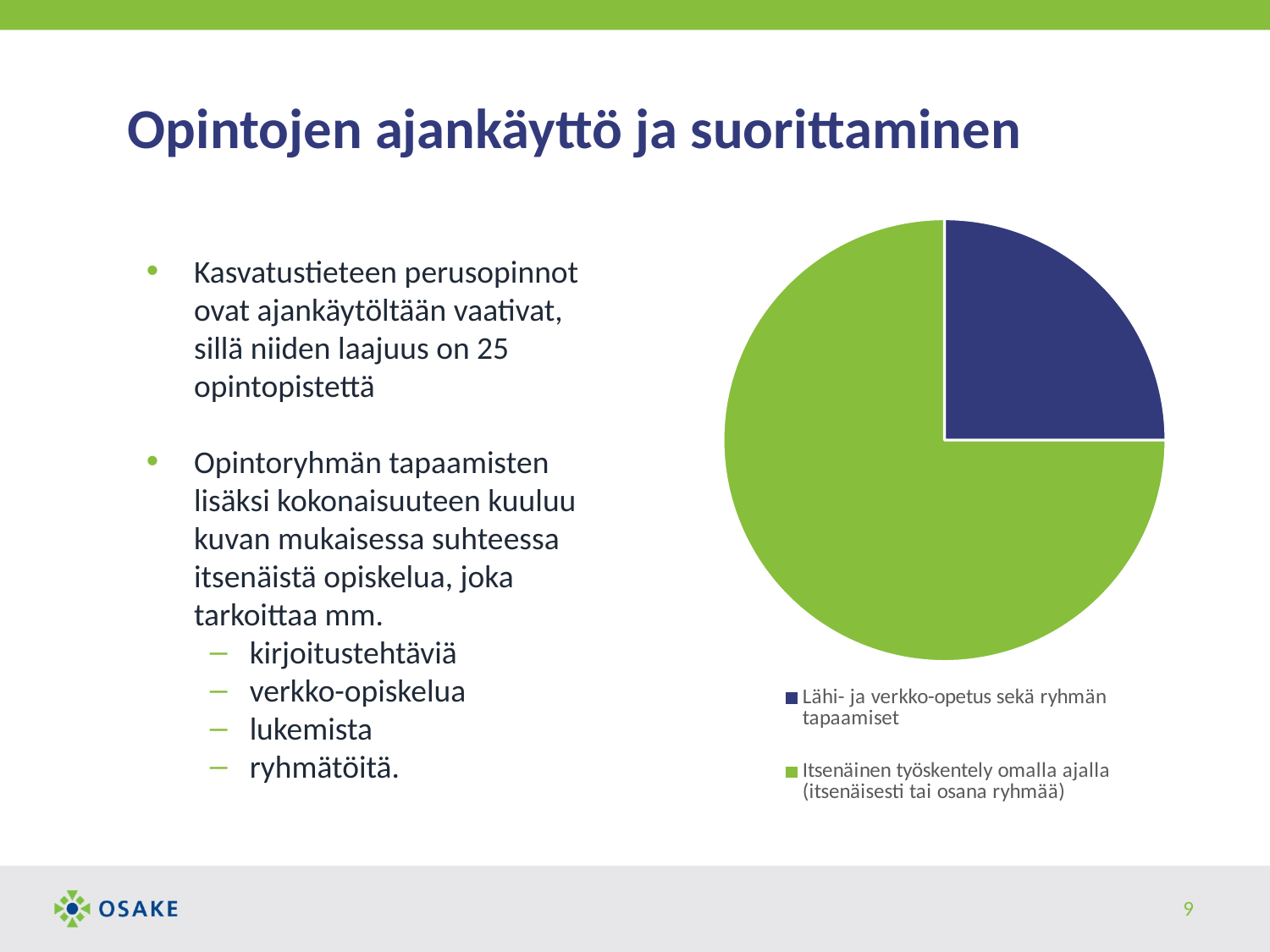
How many slices does the pie chart have? 2 How many entries does the legend of the pie chart list? 2 Which slice of the pie chart is the smallest? Lähi- ja verkko-opetus sekä ryhmän tapaamiset What kind of chart is shown on the slide? pie chart Which is larger in the pie chart: the slice for 'Lähi- ja verkko-opetus sekä ryhmän tapaamiset' or the slice for 'Itsenäinen työskentely omalla ajalla (itsenäisesti tai osana ryhmää)'? Itsenäinen työskentely omalla ajalla (itsenäisesti tai osana ryhmää) Which slice of the pie chart is the largest? Itsenäinen työskentely omalla ajalla (itsenäisesti tai osana ryhmää) What colour is the slice for 'Itsenäinen työskentely omalla ajalla (itsenäisesti tai osana ryhmää)' in the pie chart? green What colour is the slice for 'Lähi- ja verkko-opetus sekä ryhmän tapaamiset' in the pie chart? dark blue